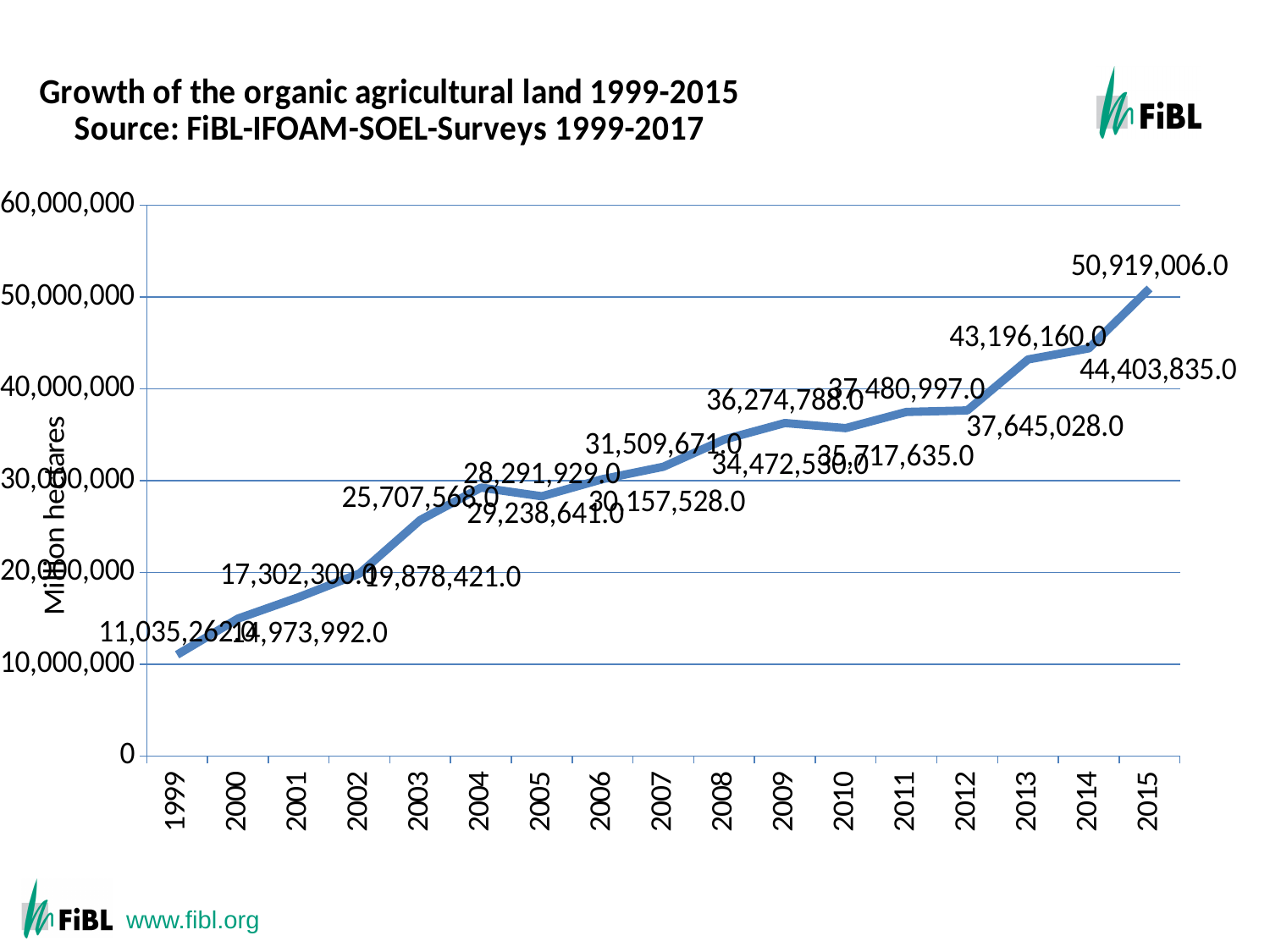
What is the value for 2015? 50,919,006.0 What is the value for 2009? 36,274,788.0 Which year has the highest value? 2015 How many years are plotted on the x axis? 17 Which year has the lowest value? 1999 What is the value for 2000? 14,973,992.0 Is the value for 2003 greater or less than 20,000,000? greater What is the value for 2013? 43,196,160.0 Do the values generally rise or fall from 1999 to 2015? rise What is the difference between the values for 2015 and 2014? 6,515,171.0 What kind of chart is shown? line chart Which is larger, the value for 2009 or the value for 2010? 2009